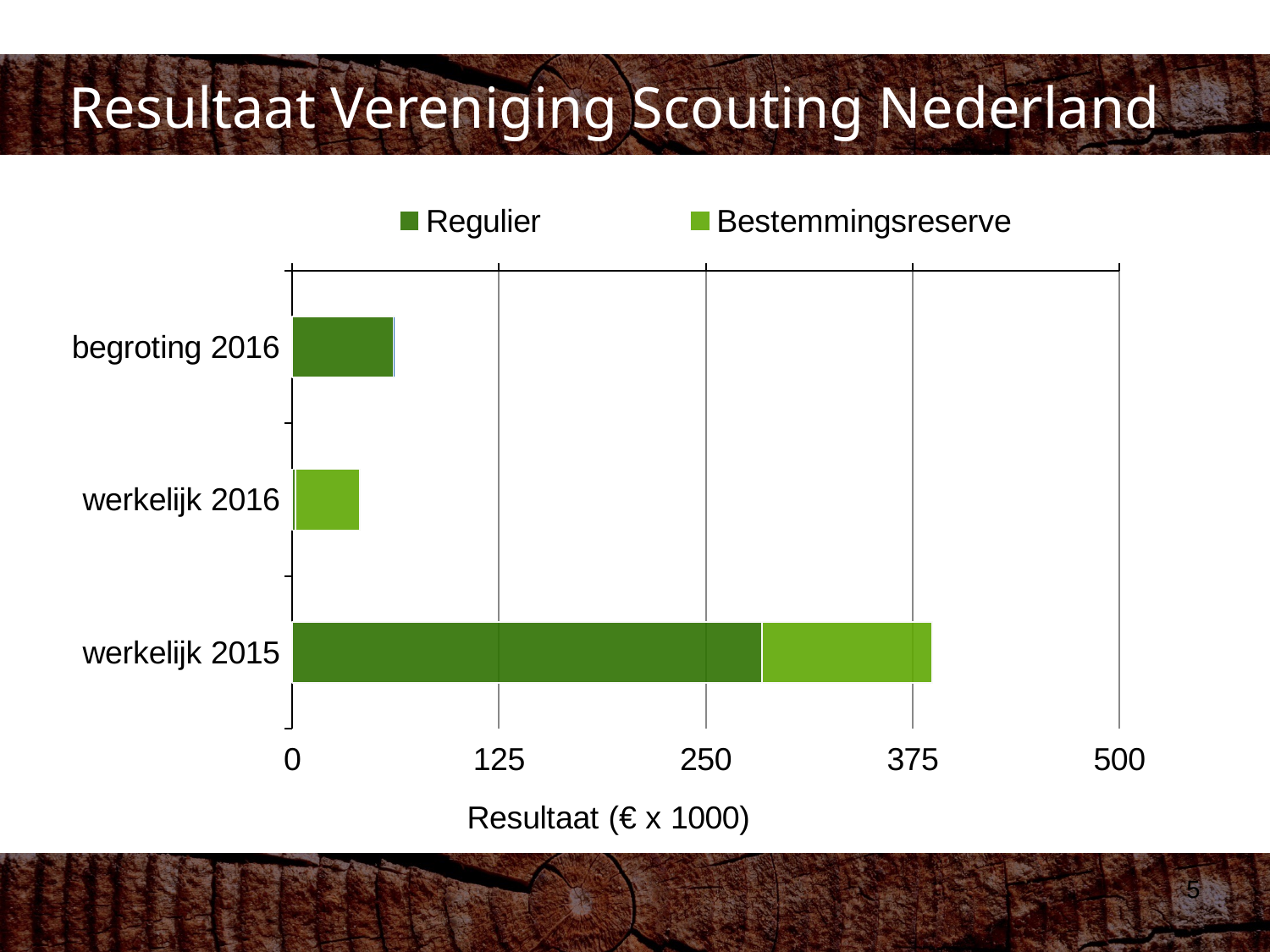
What kind of chart is shown on the slide? bar chart What is the title of the slide? Resultaat Vereniging Scouting Nederland Is the total bar for werkelijk 2015 greater or less than 375? greater Which category has the shortest total bar? werkelijk 2016 Is the Regulier value for begroting 2016 greater or less than 125? less What is the label on the horizontal axis? Resultaat (€ x 1000) How many categories are shown on the chart? 3 Which category has the longest total bar? werkelijk 2015 How many series does the legend list? 2 Which is larger for werkelijk 2015: the Regulier value or the Bestemmingsreserve value? Regulier Is the Regulier value for werkelijk 2015 greater or less than 250? greater